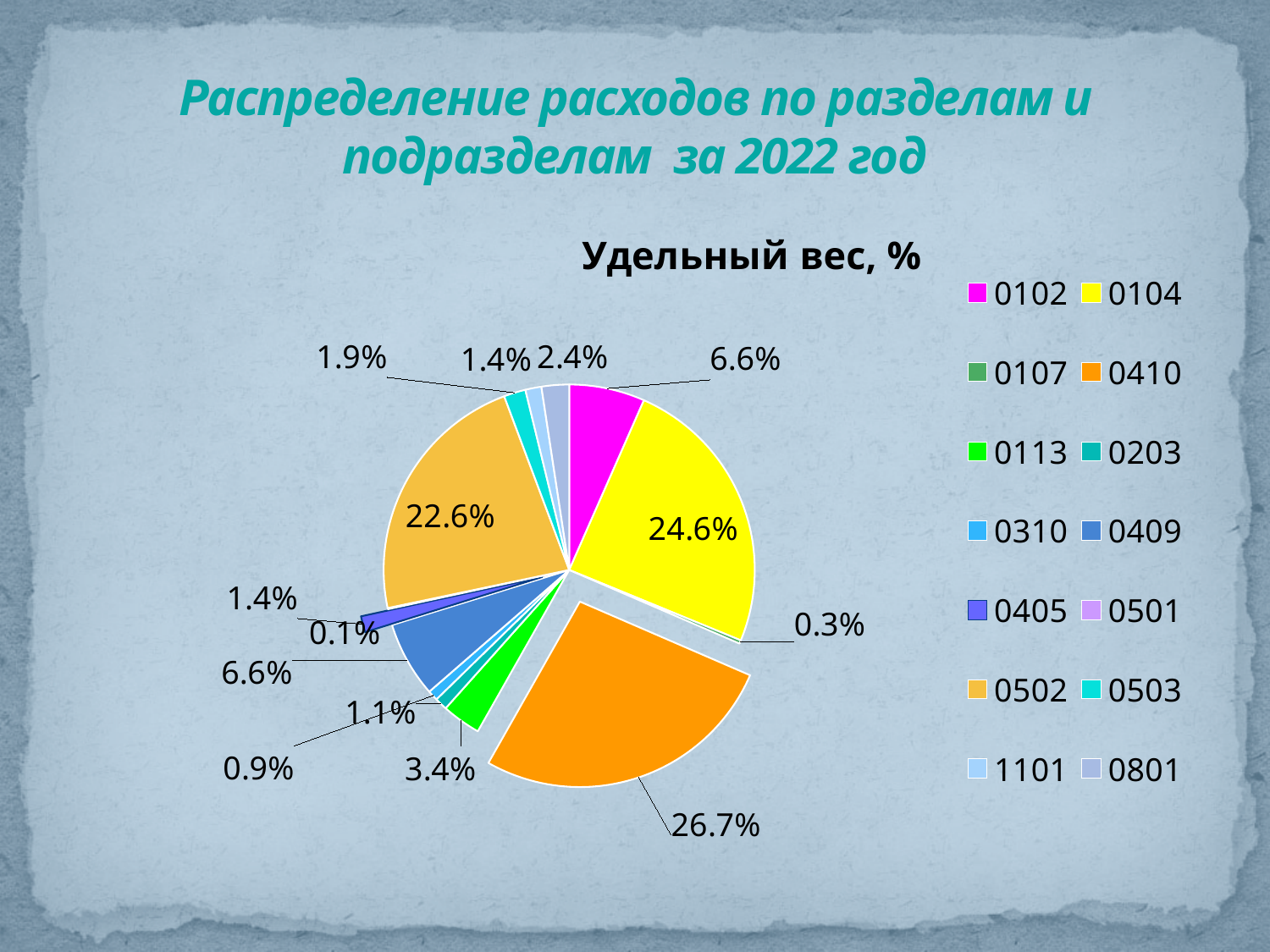
What is the share for category 0102? 6.6% What is the share for category 0410? 26.7% Which is larger, the share for 0104 or the share for 0502? 0104 What is the smallest percentage labelled on the chart? 0.1% Which category has the largest share of the pie? 0410 What is the share for category 0113? 3.4% What kind of chart is shown on the slide? pie chart What is the share for category 0104? 24.6% How many categories does the chart legend list? 14 What is the title of the chart? Удельный вес, % What is the share for category 0502? 22.6% What is the difference between the shares of 0410 and 0104? 2.1%